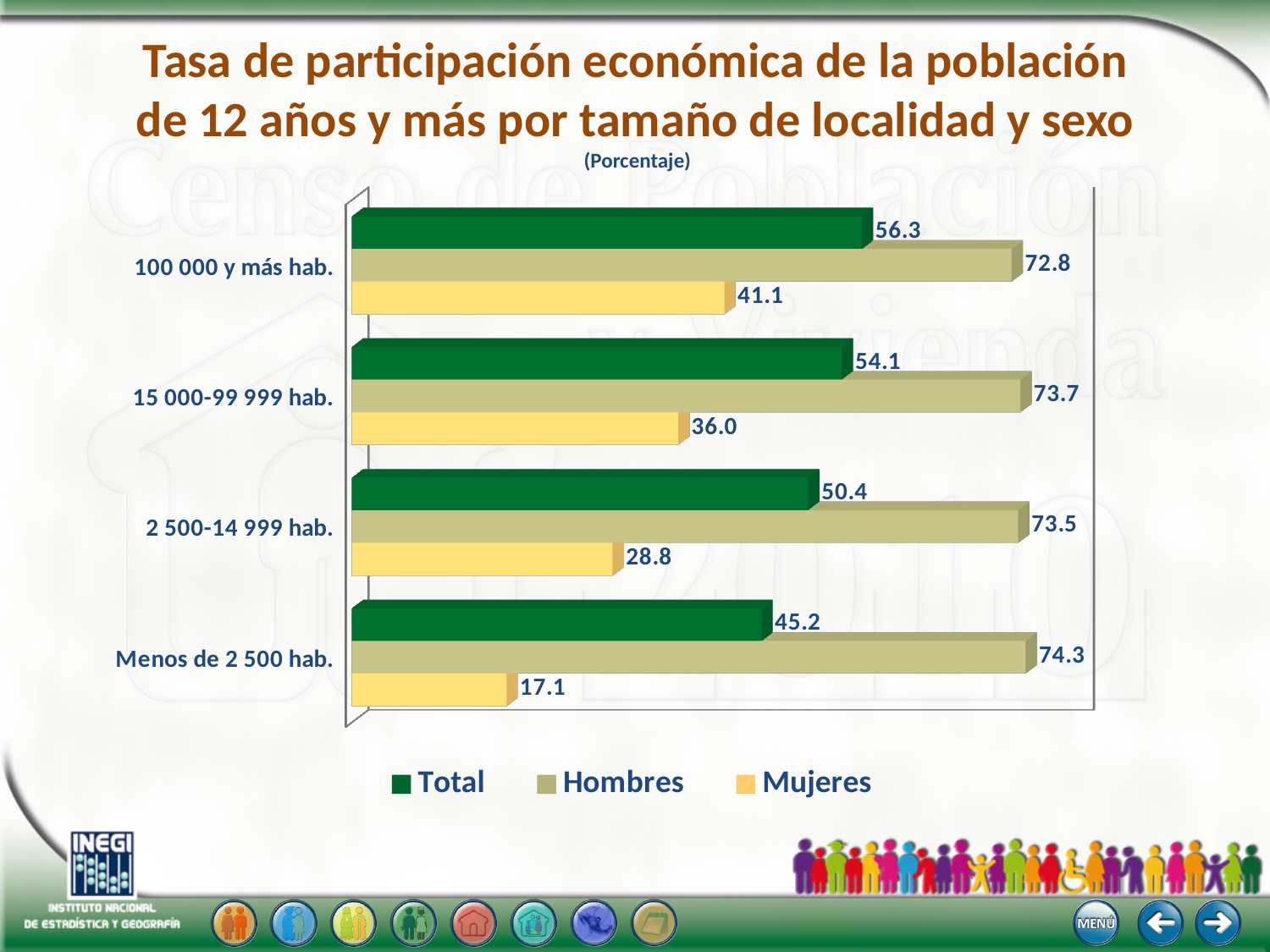
How many series does the legend list? 3 What kind of chart is shown on the slide? Bar chart What is the Total value for 15 000-99 999 hab.? 54.1 What is the Hombres value for Menos de 2 500 hab.? 74.3 What is the difference between the Total values for 100 000 y más hab. and Menos de 2 500 hab.? 11.1 What is the Mujeres value for 100 000 y más hab.? 41.1 Which locality size has the lowest Mujeres value? Menos de 2 500 hab. What is the difference between the Hombres and Mujeres values for 2 500-14 999 hab.? 44.7 Which locality size has the highest Total value? 100 000 y más hab. How many locality size categories are shown in the chart? 4 Which is larger for 15 000-99 999 hab., the Total value or the Mujeres value? Total Which series is shown in yellow? Mujeres